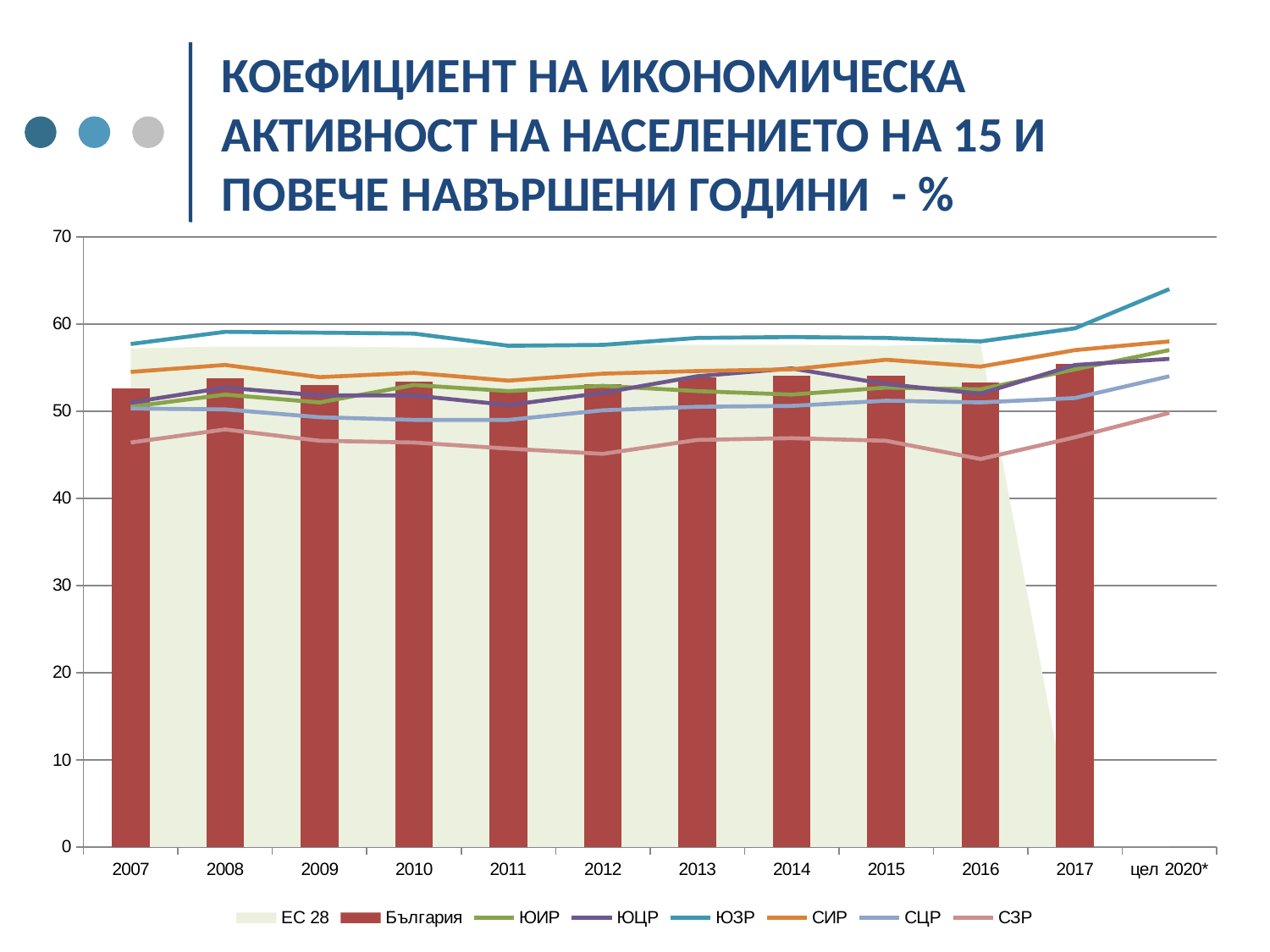
Is the value for СЗР in 2016 greater or less than 50? less Which is larger in 2010, ЮЗР or СЗР? ЮЗР Is the value for България in 2017 greater or less than 60? less Which line series has the lowest value in 2017? СЗР Is the value for ЮЗР in 2007 greater or less than 50? greater What is the last category on the x axis? цел 2020* Which series has the highest value in 2017? ЮЗР How many series does the legend list? 8 Does the ЮЗР line rise or fall from 2016 to цел 2020*? rise How many categories are shown on the x axis? 12 Which series is drawn as bars in the chart? България